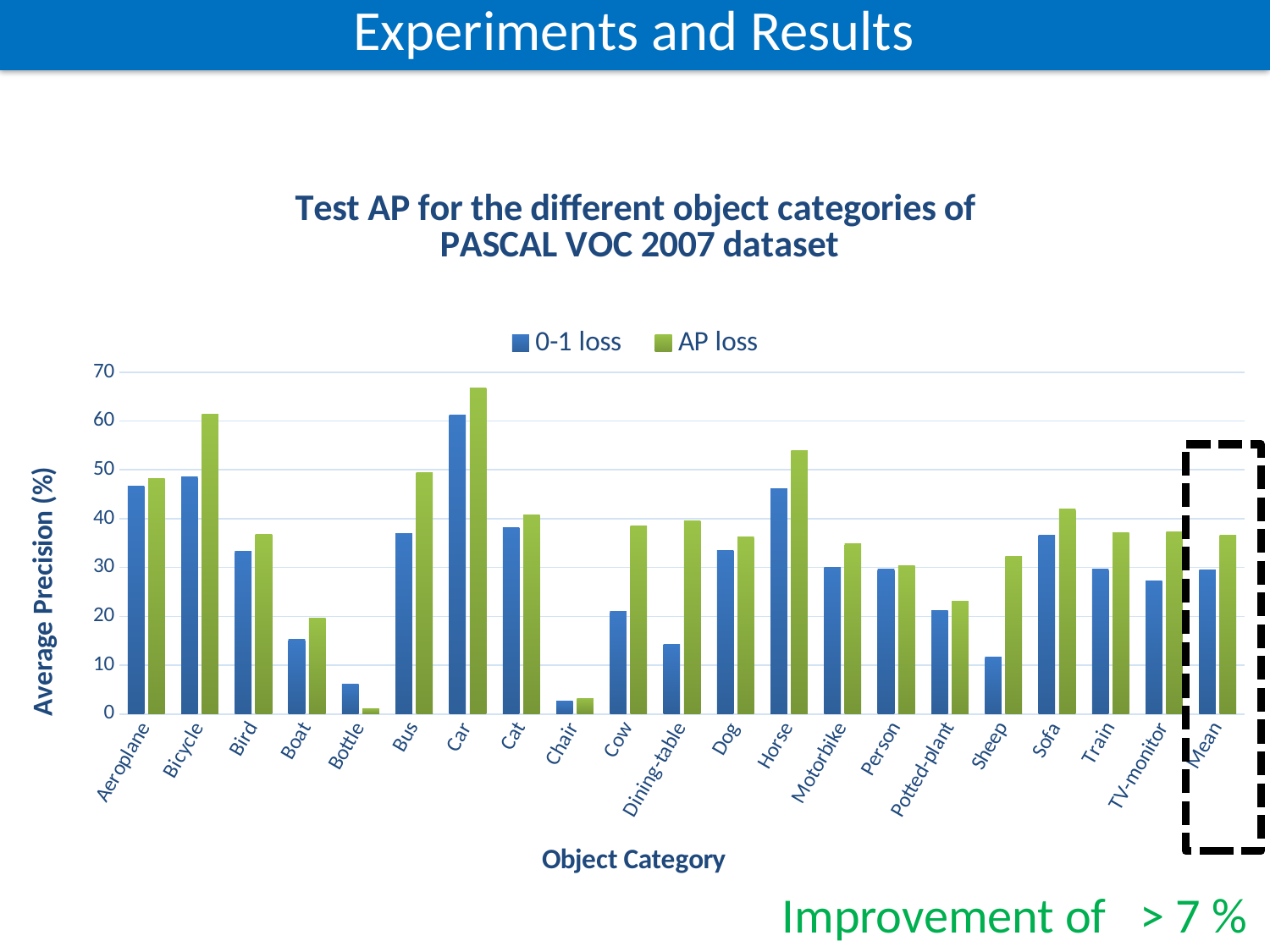
What kind of chart is shown on the slide? Bar chart Is the AP loss value for Mean greater or less than 30? greater Which object category has the highest AP loss value? Car Which object category has the lowest AP loss value? Bottle Which object category has the lowest 0-1 loss value? Chair What is the label of the y axis? Average Precision (%) Is the AP loss value for Car greater or less than 60? greater Is the 0-1 loss value for Sheep greater or less than 20? less How many series does the legend list? 2 For Bottle, which series has the larger value, 0-1 loss or AP loss? 0-1 loss How many object categories are shown on the x axis, including Mean? 21 Which object category has the highest 0-1 loss value? Car